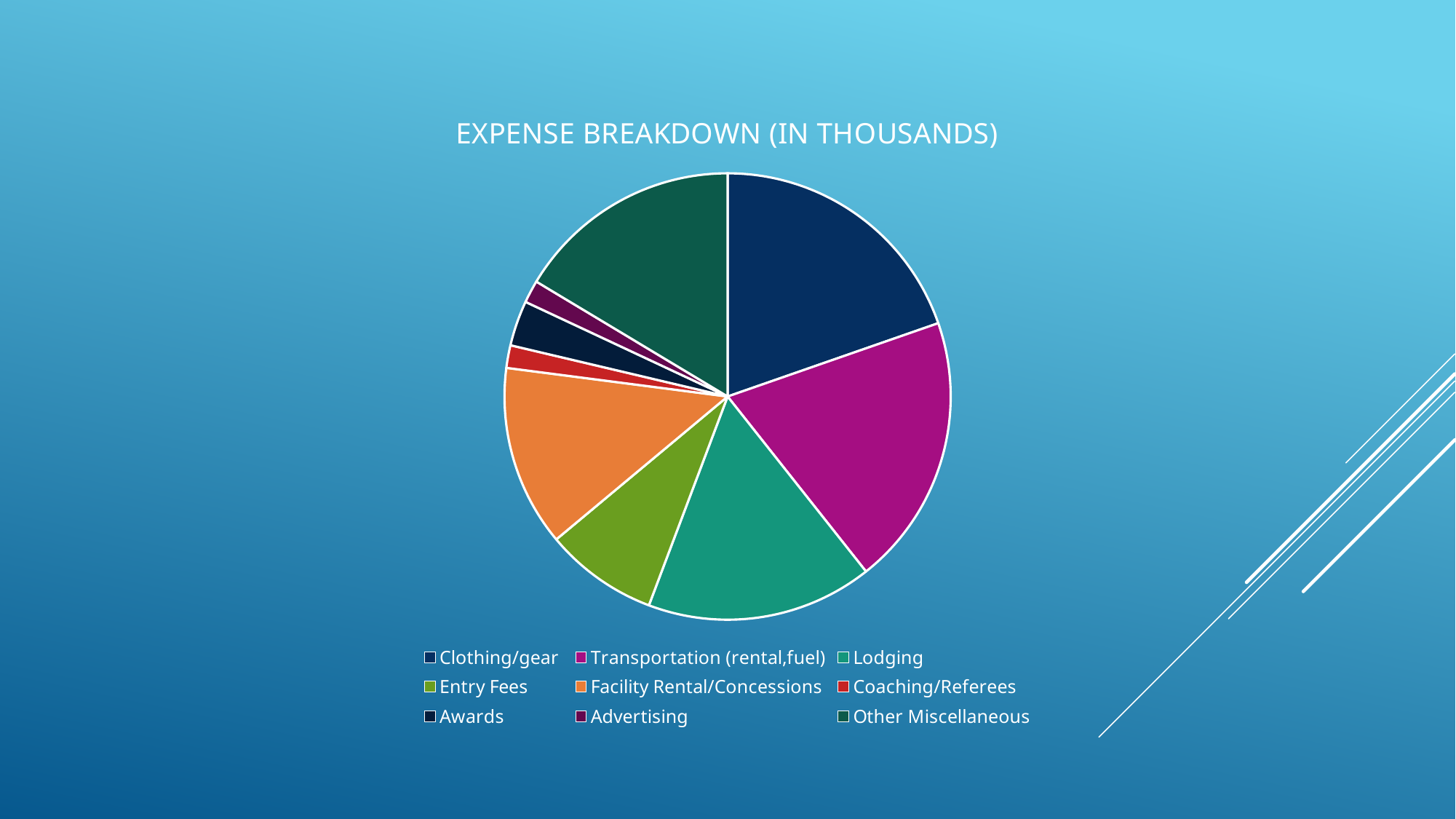
Which expense category is shown in orange in the pie chart? Facility Rental/Concessions How many entries does the legend list? 9 How many expense categories (slices) does the pie chart have? 9 Which is larger, the slice for Facility Rental/Concessions or the slice for Awards? Facility Rental/Concessions What kind of chart is shown on the slide? Pie chart Which is larger, the slice for Transportation (rental,fuel) or the slice for Entry Fees? Transportation (rental,fuel) Which is larger, the slice for Other Miscellaneous or the slice for Advertising? Other Miscellaneous What is the title of the chart? Expense Breakdown (in thousands)